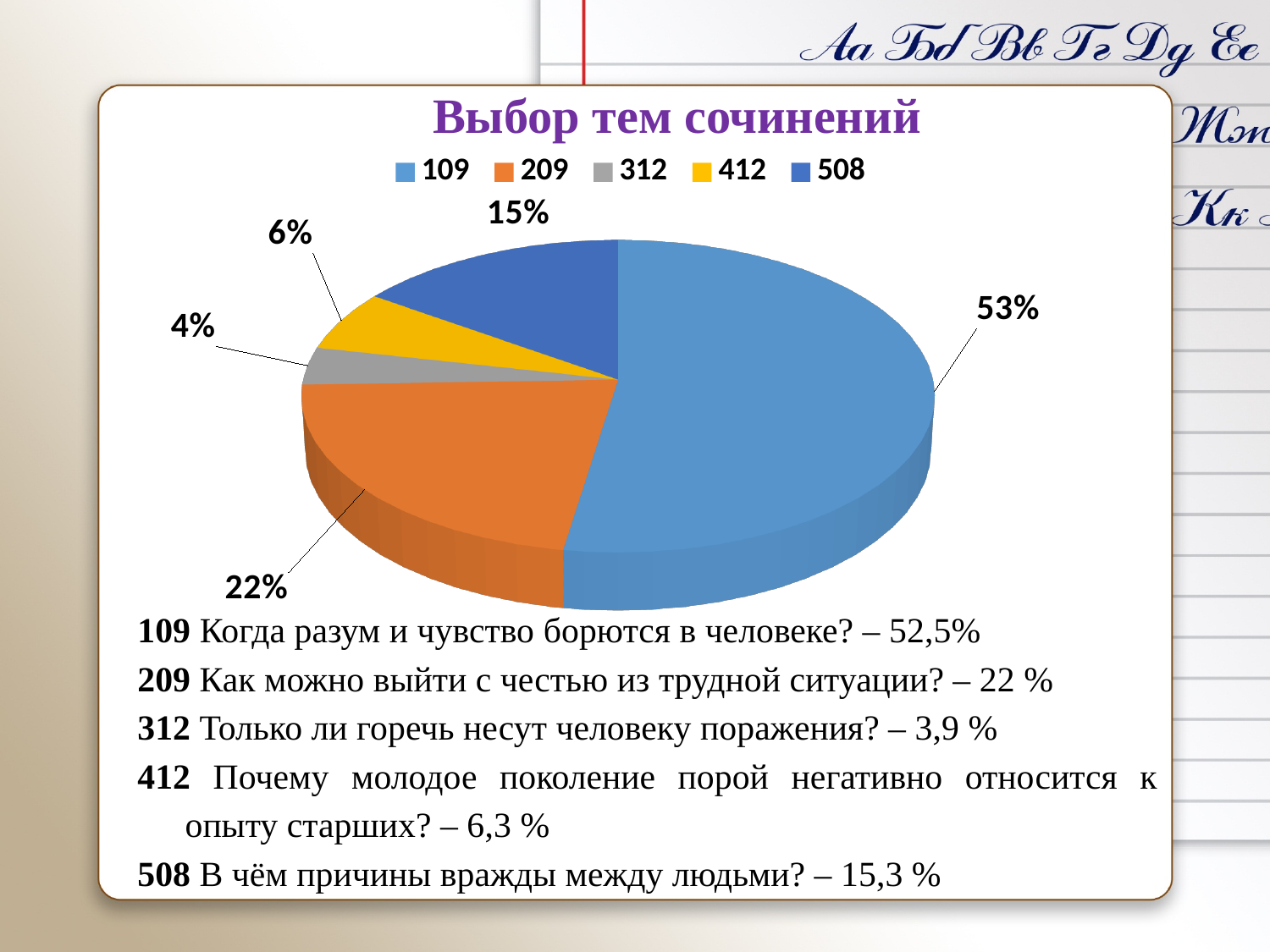
What type of chart is shown on the slide? pie chart Which topic has the smallest slice of the pie? 312 Which topic has the largest slice of the pie? 109 What share of the pie does topic 412 have? 6% What share of the pie does topic 209 have? 22% What share of the pie does topic 312 have? 4% What is the title of the chart? Выбор тем сочинений What share of the pie does topic 109 have? 53% What is the difference in percentage points between the slices for topic 109 and topic 209? 31 Which slice is larger, topic 508 or topic 412? 508 How many categories does the legend of the chart list? 5 What share of the pie does topic 508 have? 15%